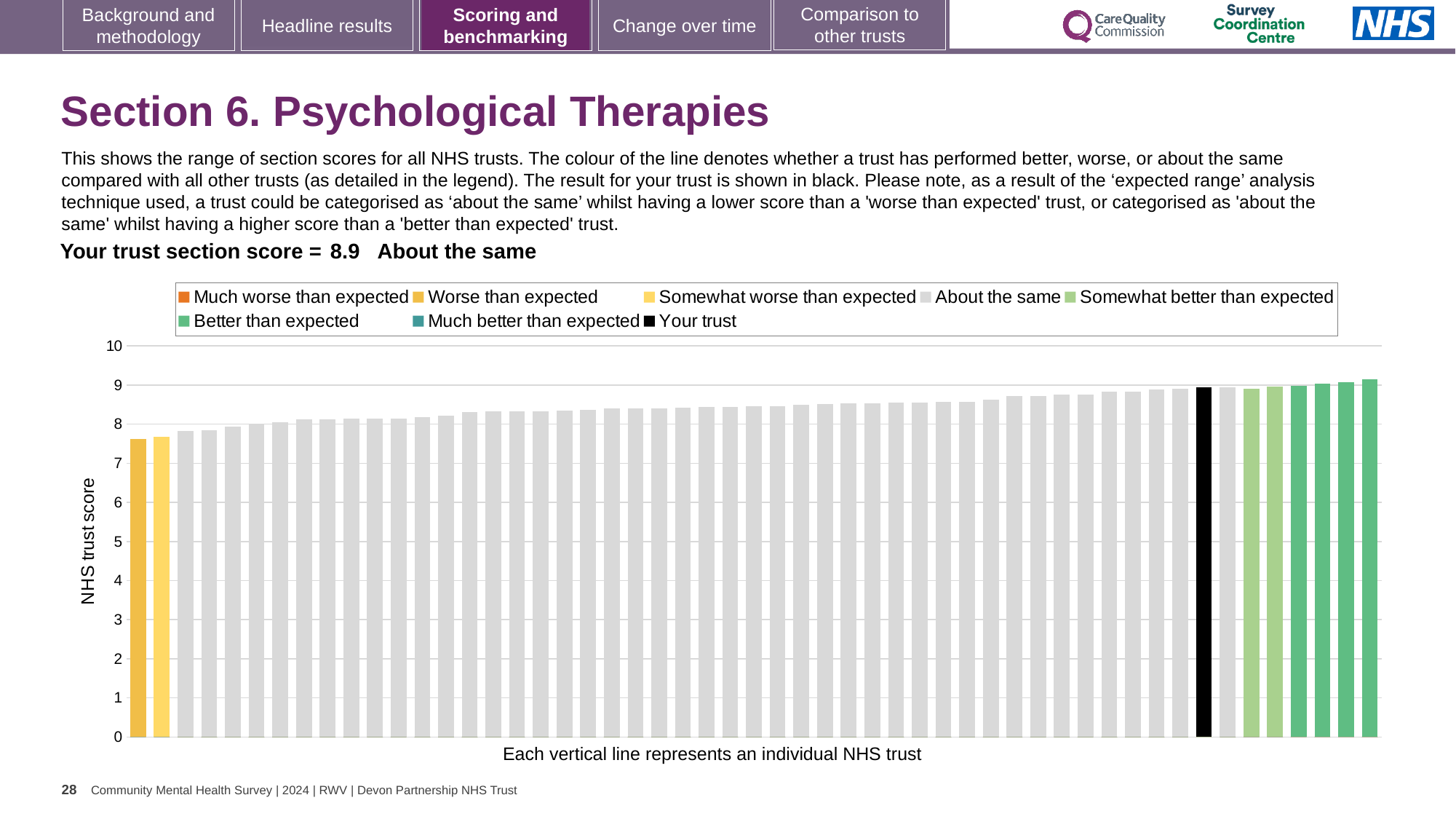
Which performance category is your trust placed in for this section? About the same Is the value for your trust (the black bar) greater or less than 8? greater How many bars are coloured as 'Better than expected' (the darker green bars)? 4 Which is larger, the value for your trust (black bar) or the value of the leftmost bar? your trust Is the value of the lowest bar in the chart greater or less than 7? greater What kind of chart is shown on the slide? bar chart Is the value of the highest bar in the chart greater or less than 8? greater Do the bar values rise or fall from left to right along the x axis? rise What is the section score for your trust shown on the slide? 8.9 How many entries does the chart legend list? 8 What is the label on the vertical axis of the chart? NHS trust score